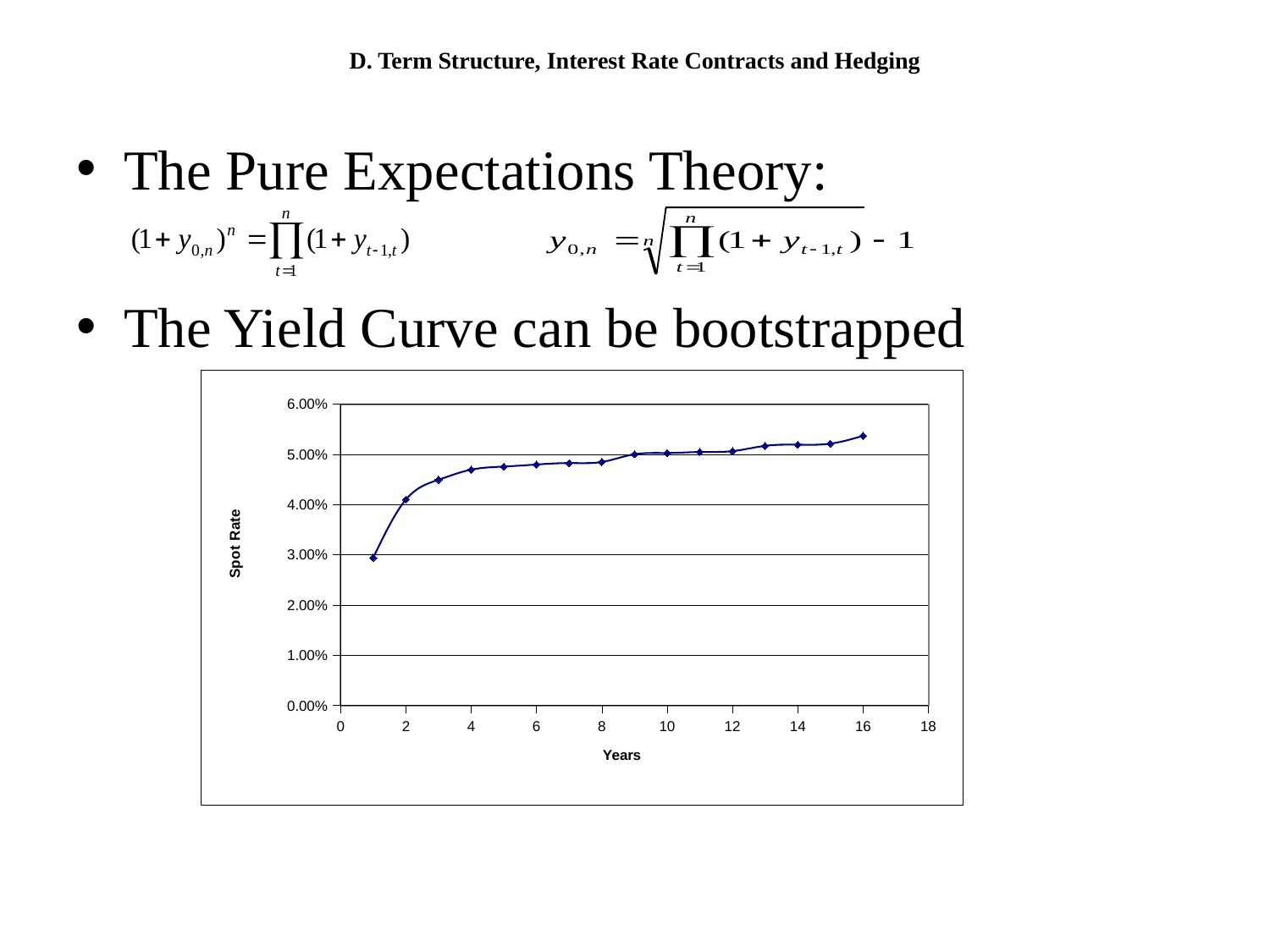
Is the spot rate at year 16 greater or less than 5.00%? greater At which year is the spot rate lowest? 1 At which year is the spot rate highest? 16 Which has the larger spot rate, year 1 or year 16? year 16 Do the spot rates rise or fall as the number of years increases? rise Is the spot rate at year 3 greater or less than 4.00%? greater Is the spot rate at year 8 greater or less than 5.00%? less What is the label of the vertical axis? Spot Rate How many data points are plotted on the yield curve? 16 What kind of chart is shown on the slide? line chart What is the label of the horizontal axis? Years